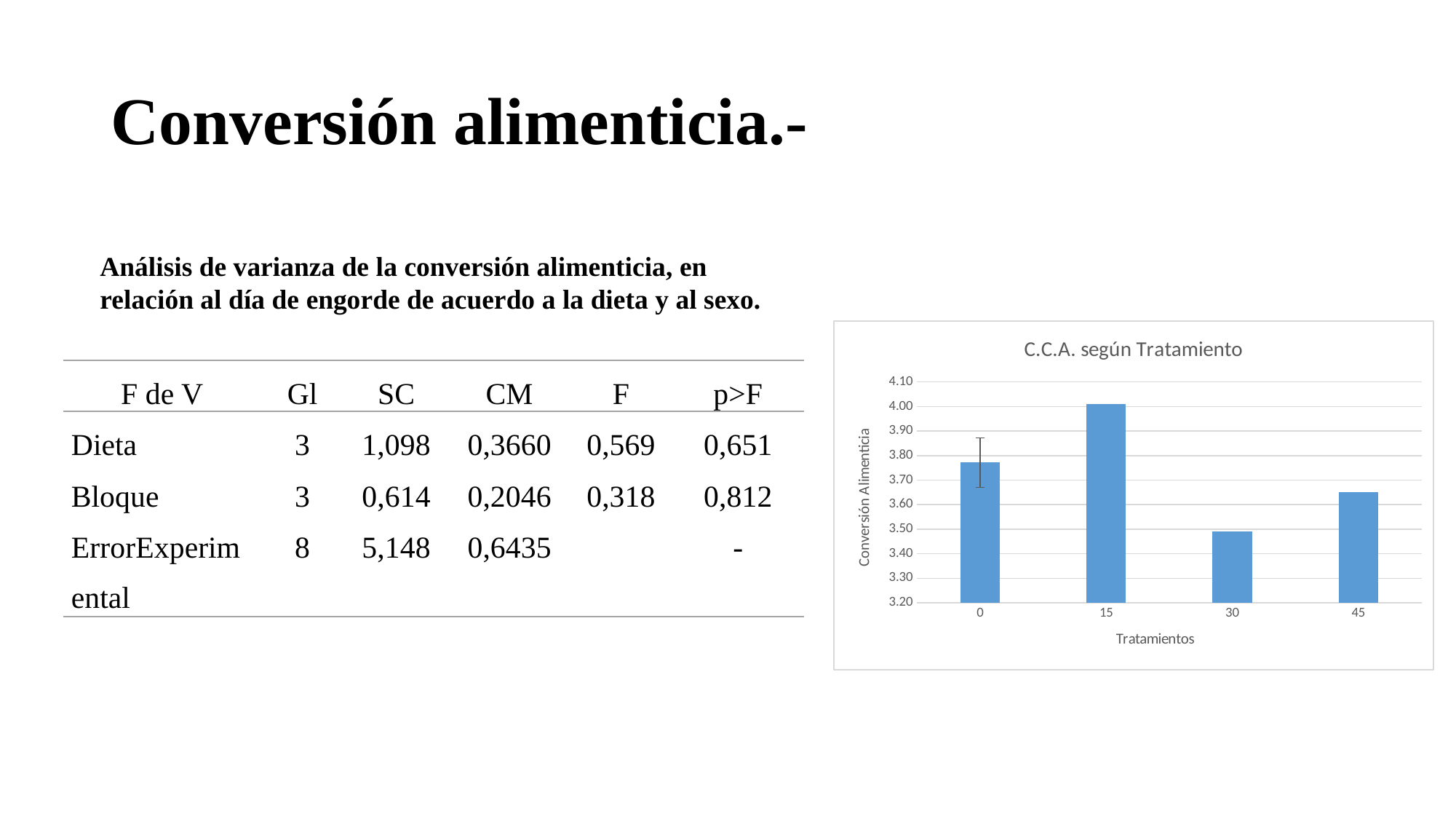
What is the title of the chart? C.C.A. según Tratamiento Which treatment has the highest conversión alimenticia in the chart? 15 Is the value for treatment 15 greater or less than 3.90? greater What type of chart is shown on the slide? bar chart Is the value for treatment 45 greater or less than 3.70? less How many treatment categories are plotted in the chart? 4 Which treatment has the lowest conversión alimenticia in the chart? 30 What is the label of the x axis of the chart? Tratamientos Does the value rise or fall from treatment 15 to treatment 30? fall Is the value for treatment 0 greater or less than 3.70? greater Which has the larger conversión alimenticia, treatment 0 or treatment 45? 0